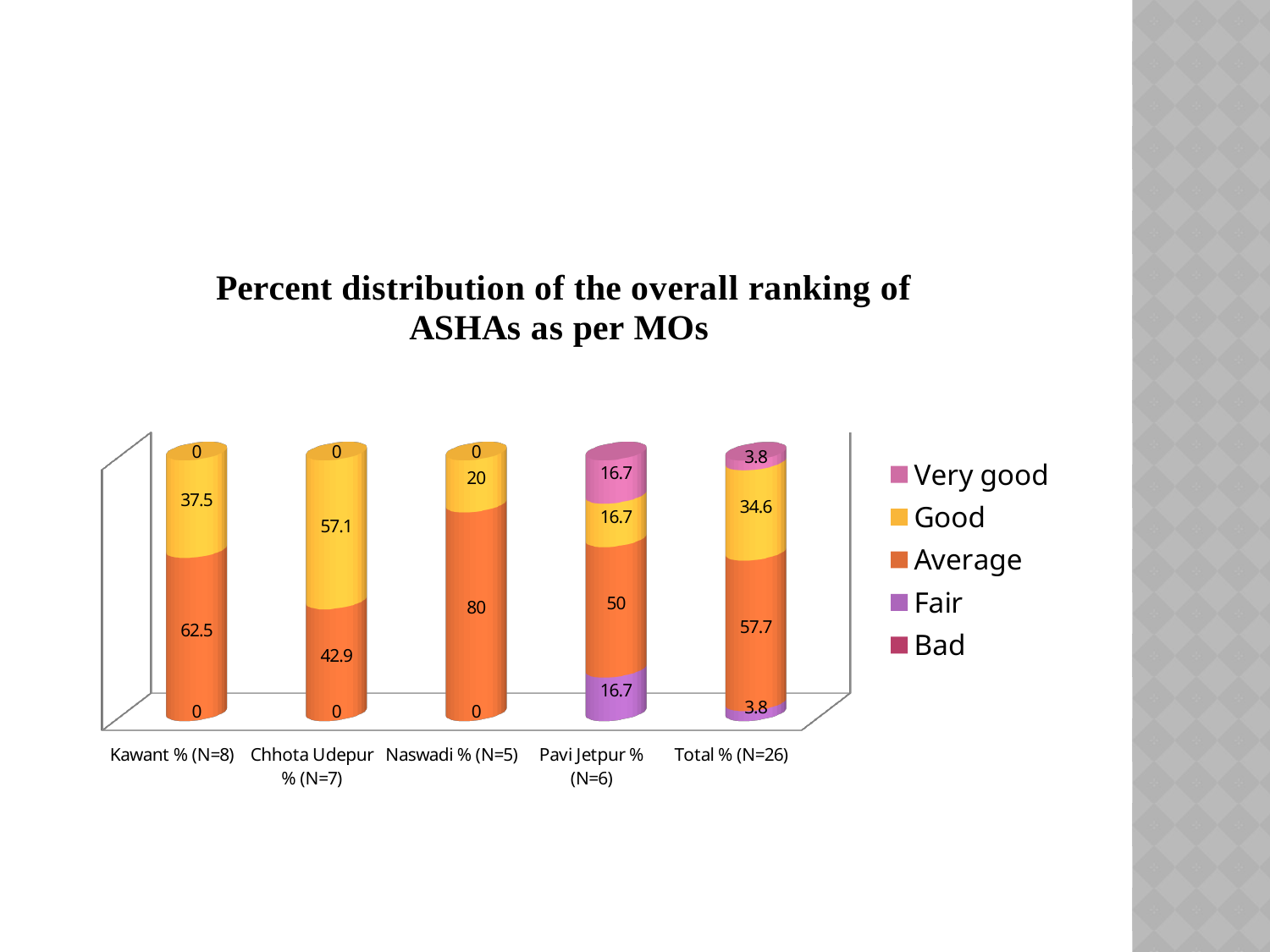
Which is larger, the Good value for Kawant % (N=8) or the Good value for Naswadi % (N=5)? Kawant % (N=8) How many series does the legend list? 5 What is the Average value for Naswadi % (N=5)? 80 Which category has the highest Average value? Naswadi % (N=5) What kind of chart is shown on the slide? Stacked bar chart What is the Very good value for Pavi Jetpur % (N=6)? 16.7 What is the Good value for Chhota Udepur % (N=7)? 57.1 What is the Average value for Kawant % (N=8)? 62.5 How many categories are shown on the x axis? 5 What is the difference between the Average value for Kawant % (N=8) and the Average value for Chhota Udepur % (N=7)? 19.6 What is the Good value for Total % (N=26)? 34.6 What is the title of the chart? Percent distribution of the overall ranking of ASHAs as per MOs